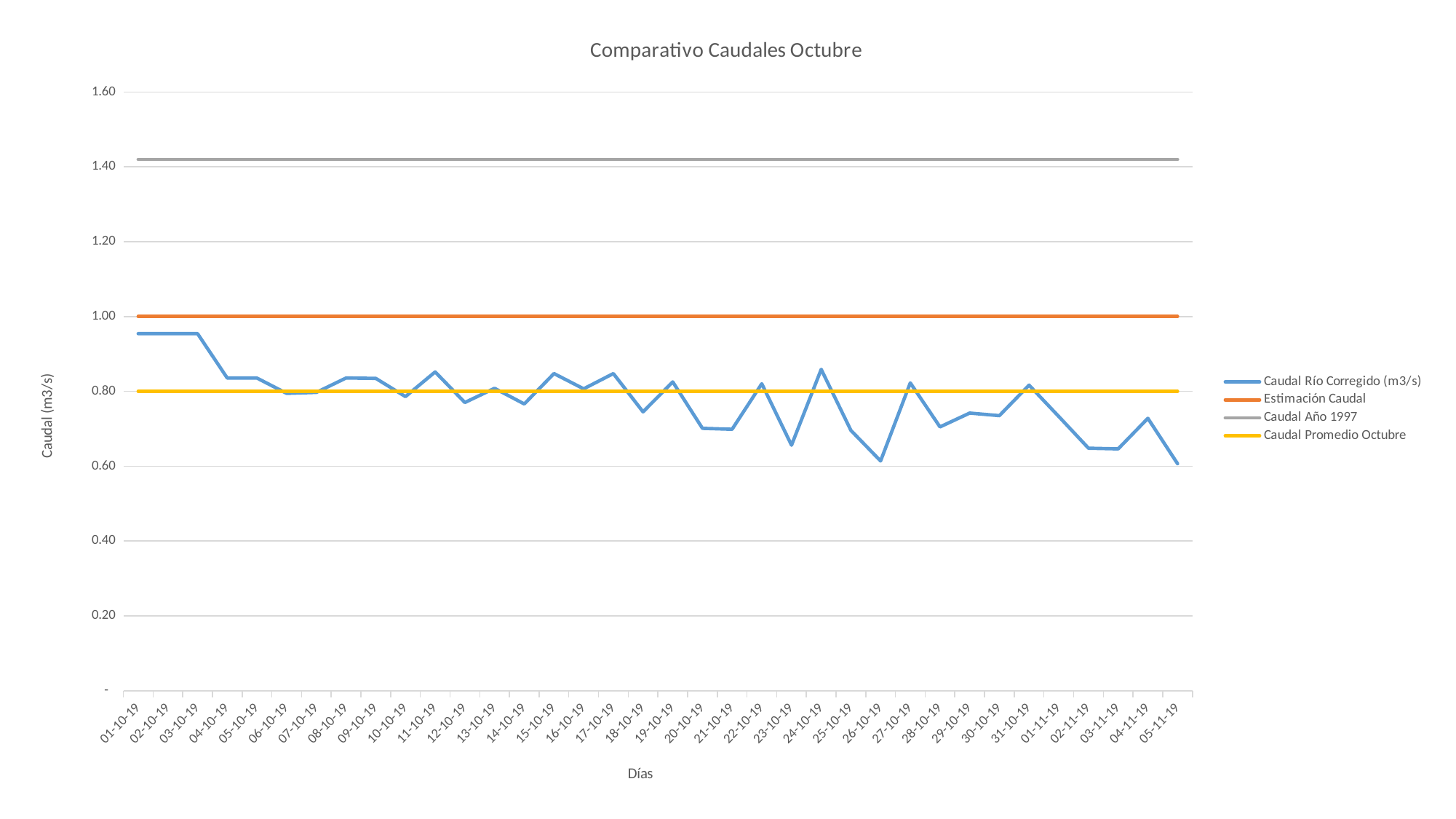
Does the Caudal Río Corregido (m3/s) line generally rise or fall from 01-10-19 to 05-11-19? Fall What is the title of the chart? Comparativo Caudales Octubre Which series has the highest values, Caudal Año 1997 or Estimación Caudal? Caudal Año 1997 Which series has the lowest value on 05-11-19? Caudal Río Corregido (m3/s) Is the value for Caudal Río Corregido (m3/s) on 01-10-19 greater or less than 0.80? greater How many series does the legend list? 4 What kind of chart is shown on the slide? Line chart How many dates are shown along the x axis? 36 Is the value for Caudal Río Corregido (m3/s) on 26-10-19 greater or less than 0.80? less Is the value of the Caudal Año 1997 line greater or less than 1.20? greater What is the value of the Caudal Promedio Octubre line? 0.80 What is the value of the Estimación Caudal line? 1.00